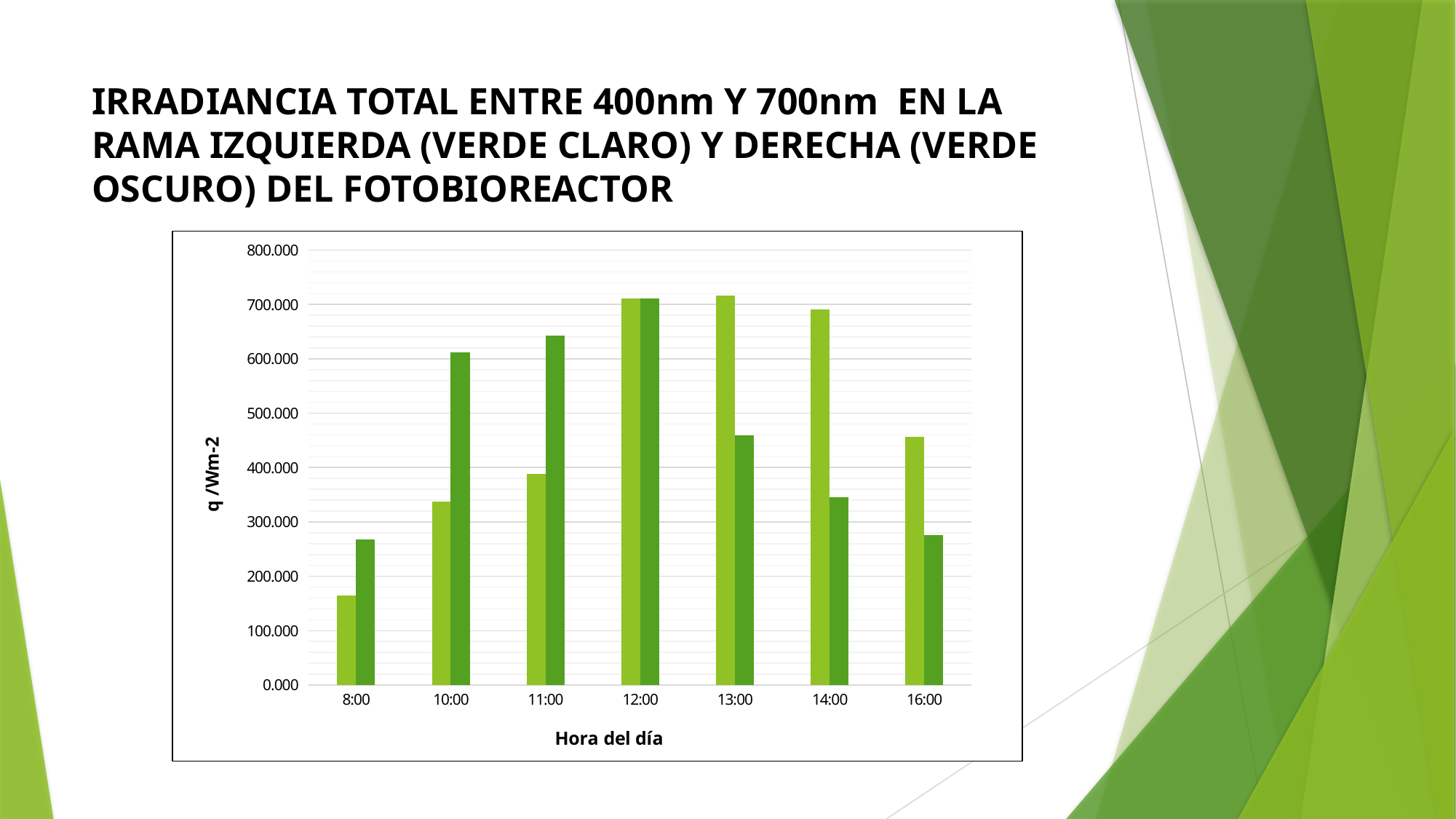
At 14:00, which branch has the higher irradiance, the light green (izquierda) or the dark green (derecha)? Light green (izquierda) Do the dark green (rama derecha) values rise or fall from 12:00 to 16:00? Fall How many time-of-day categories are shown on the x axis? 7 What is the title of the x axis? Hora del día At which hour is the light green (rama izquierda) bar lowest? 8:00 What kind of chart is shown on the slide? Bar chart Is the dark green (rama derecha) value at 10:00 greater or less than 600.000? greater Is the dark green (rama derecha) value at 16:00 greater or less than 300.000? less At 10:00, which branch has the higher irradiance, the light green (izquierda) or the dark green (derecha)? Dark green (derecha) Is the light green (rama izquierda) value at 8:00 greater or less than 200.000? less At which hour is the dark green (rama derecha) bar highest? 12:00